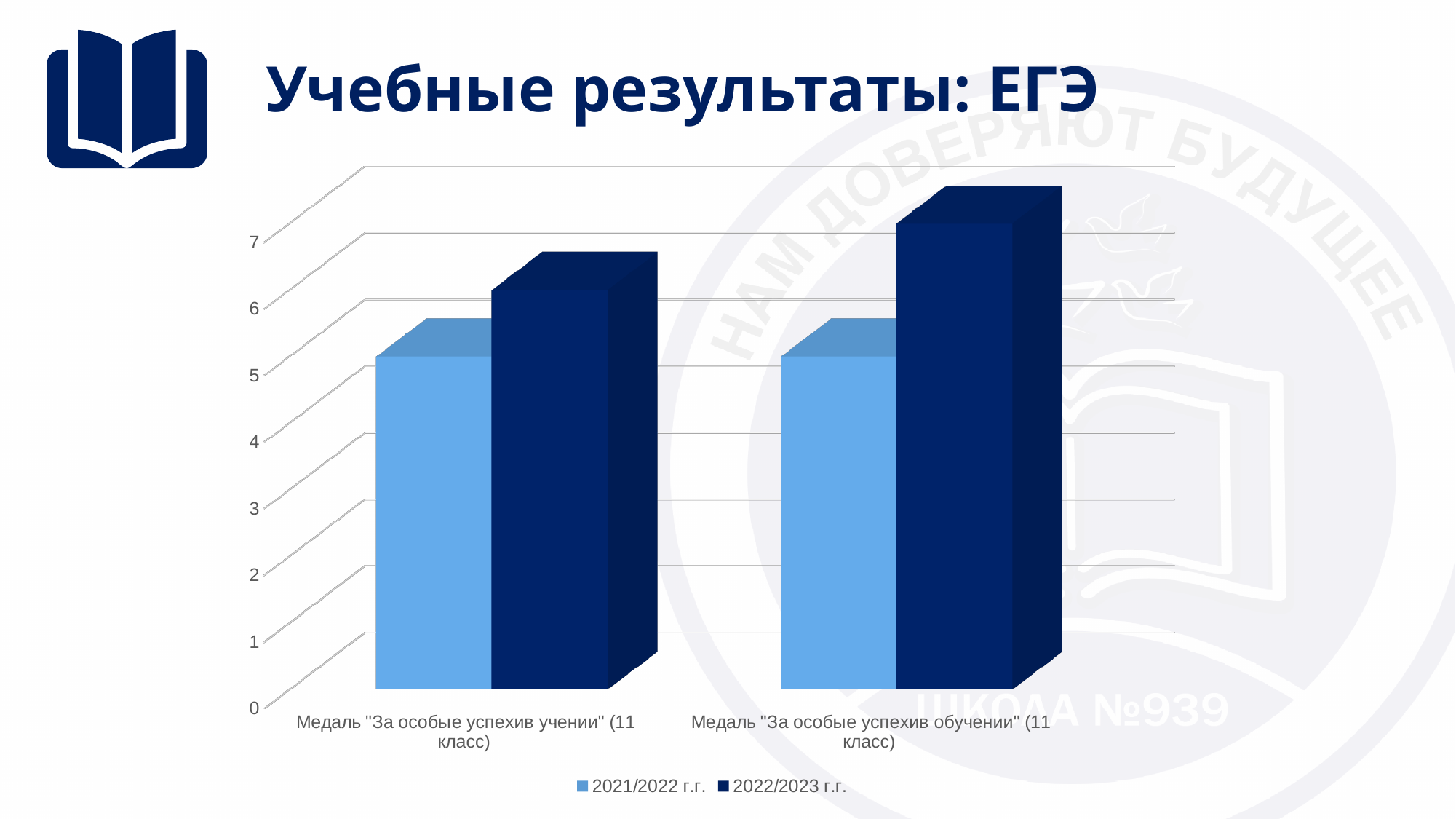
How many categories are shown on the x axis of the chart? 2 Which series is shown in dark blue in the chart? 2022/2023 г.г. Is the value for 2022/2023 г.г. for Медаль "За особые успехив обучении" (11 класс) greater or less than 6? greater Which bar is the highest in the chart? 2022/2023 г.г. for Медаль "За особые успехив обучении" (11 класс) Is the value for 2021/2022 г.г. for Медаль "За особые успехив обучении" (11 класс) greater or less than 6? less Is the value for 2021/2022 г.г. for Медаль "За особые успехив учении" (11 класс) greater or less than 4? greater What is the title of the slide containing the chart? Учебные результаты: ЕГЭ What kind of chart is shown on the slide? bar chart How many series does the chart legend list? 2 For Медаль "За особые успехив обучении" (11 класс), which series has the larger value, 2021/2022 г.г. or 2022/2023 г.г.? 2022/2023 г.г. For Медаль "За особые успехив учении" (11 класс), which series has the larger value, 2021/2022 г.г. or 2022/2023 г.г.? 2022/2023 г.г.